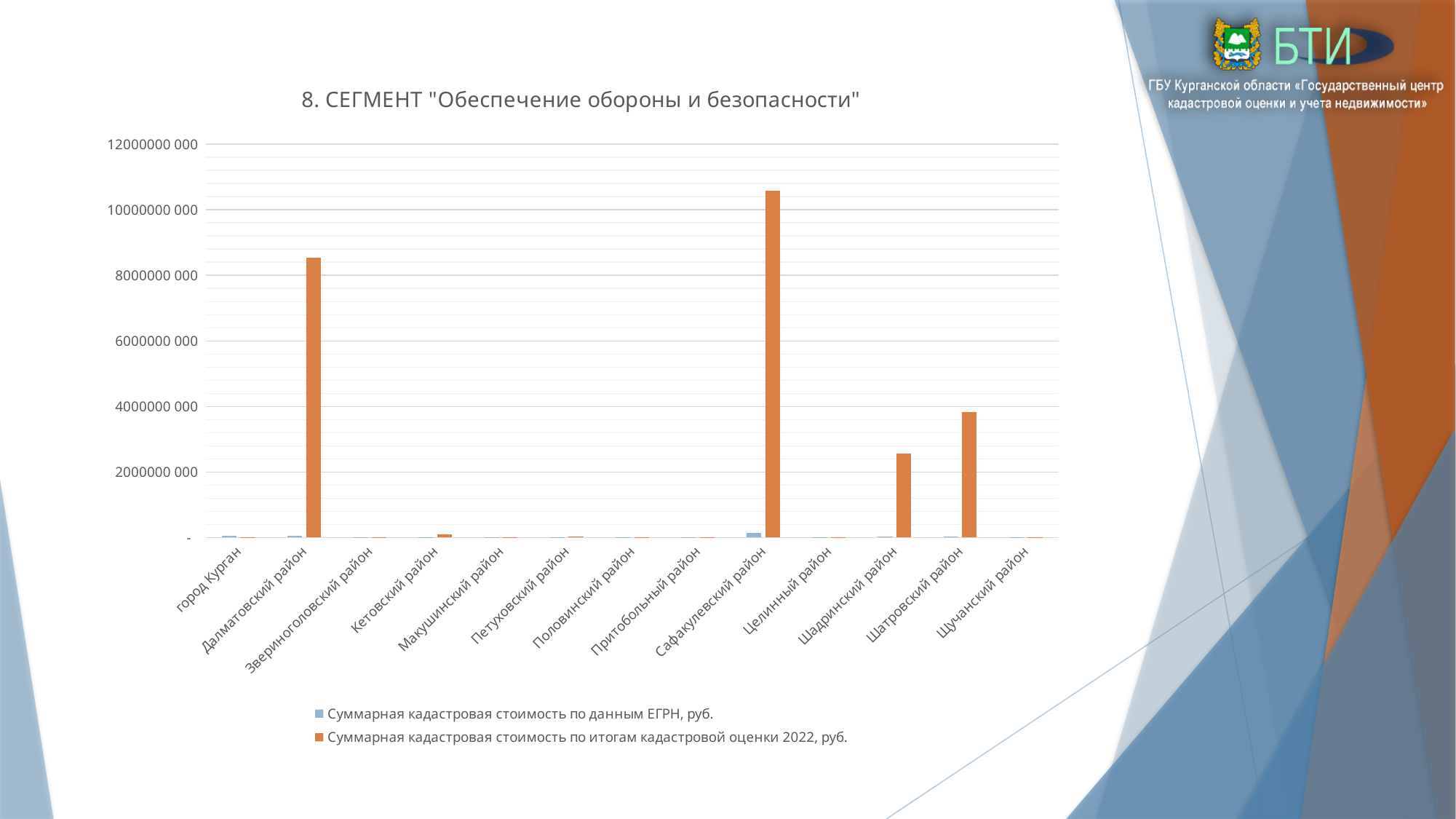
Is the value for Далматовский район in the series "Суммарная кадастровая стоимость по итогам кадастровой оценки 2022, руб." greater or less than 8000000 000? greater Is the value for Сафакулевский район in the series "Суммарная кадастровая стоимость по итогам кадастровой оценки 2022, руб." greater or less than 10000000 000? greater How many series does the legend list? 2 Which colour represents the series "Суммарная кадастровая стоимость по данным ЕГРН, руб." in the legend? blue What is the title of the chart? 8. СЕГМЕНТ "Обеспечение обороны и безопасности" For the series "Суммарная кадастровая стоимость по итогам кадастровой оценки 2022, руб.", which is larger: Шадринский район or Шатровский район? Шатровский район Which category has the highest value for the series "Суммарная кадастровая стоимость по итогам кадастровой оценки 2022, руб."? Сафакулевский район Is the value for Шадринский район in the series "Суммарная кадастровая стоимость по итогам кадастровой оценки 2022, руб." greater or less than 2000000 000? greater How many categories (districts) are shown along the x axis? 13 For the series "Суммарная кадастровая стоимость по итогам кадастровой оценки 2022, руб.", which is larger: Далматовский район or Шатровский район? Далматовский район What kind of chart is shown on the slide? bar chart